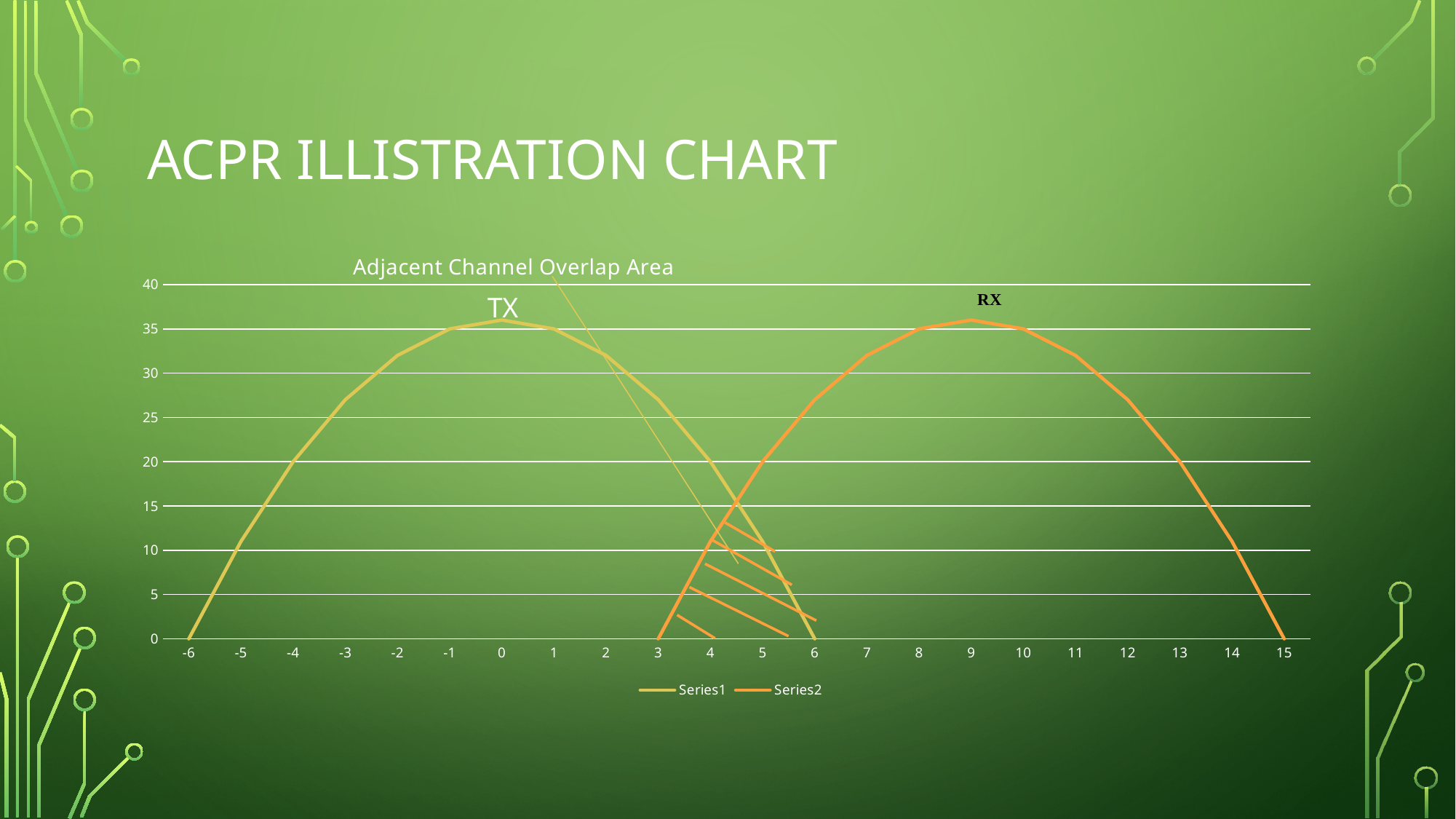
Is the value of Series1 at x = 0 greater or less than 30? greater How many series does the chart legend list? 2 At which x value does Series1 reach its highest point? 0 Does Series2 rise or fall as x goes from 9 to 15? fall At x = 5, which series has the higher value, Series1 or Series2? Series2 What kind of chart is shown on the slide? line chart How many x-axis categories does the chart have? 22 What is the value of Series2 at x = 15? 0 What is the title shown above the chart? Adjacent Channel Overlap Area Is the value of Series2 at x = 14 greater or less than 15? less At which x value does Series2 reach its highest point? 9 What is the value of Series1 at x = -6? 0